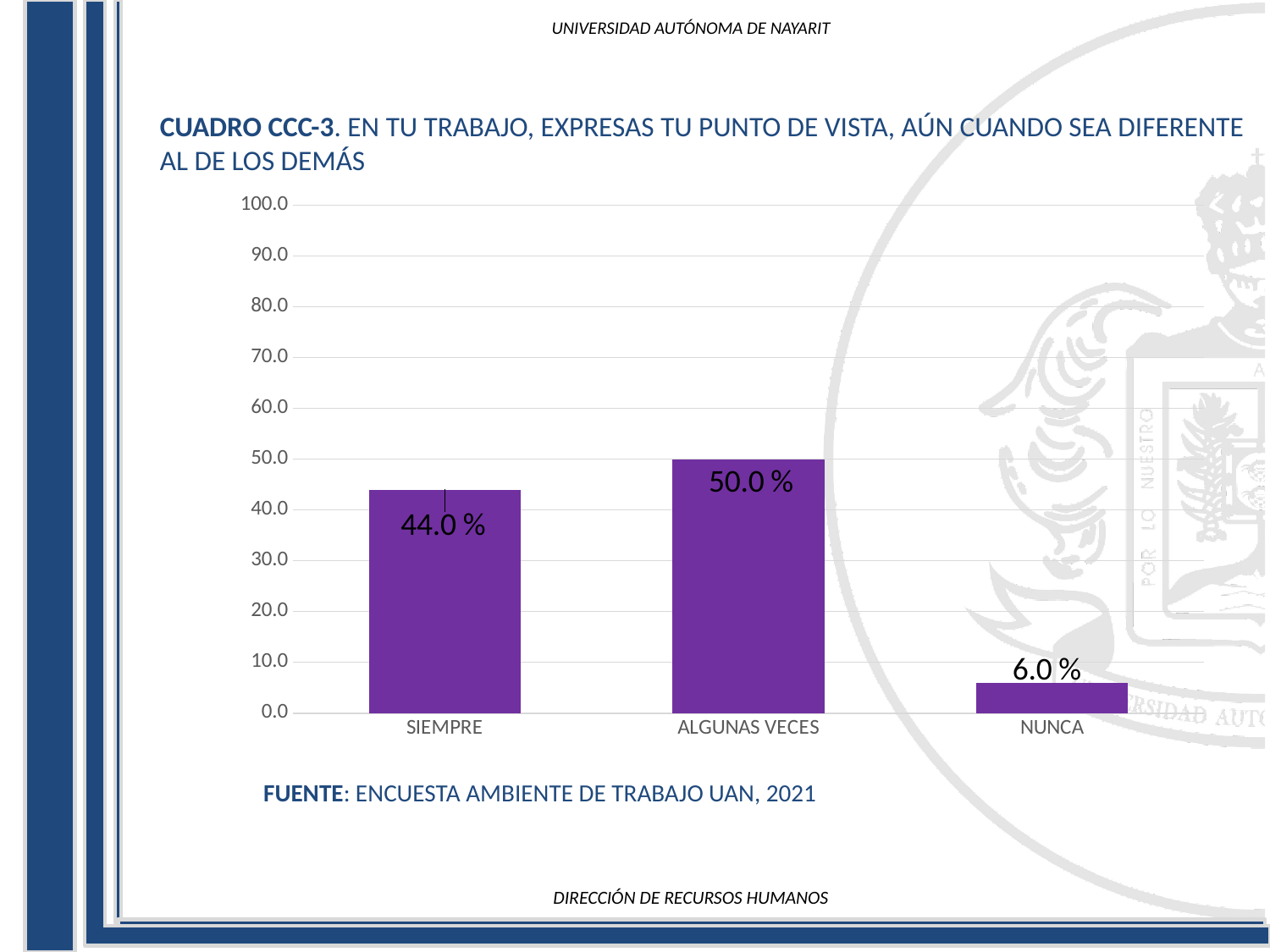
Is the value for SIEMPRE greater or less than 40.0? greater What kind of chart is shown on the slide? bar chart What is the value for SIEMPRE? 44.0 % What is the difference between the values for ALGUNAS VECES and SIEMPRE? 6.0 % What source is cited below the chart? ENCUESTA AMBIENTE DE TRABAJO UAN, 2021 What is the value for ALGUNAS VECES? 50.0 % Which category has the highest value? ALGUNAS VECES Which is larger, the value for SIEMPRE or the value for NUNCA? SIEMPRE How many categories are shown on the x axis? 3 What is the difference between the values for SIEMPRE and NUNCA? 38.0 % What is the value for NUNCA? 6.0 % Which category has the lowest value? NUNCA